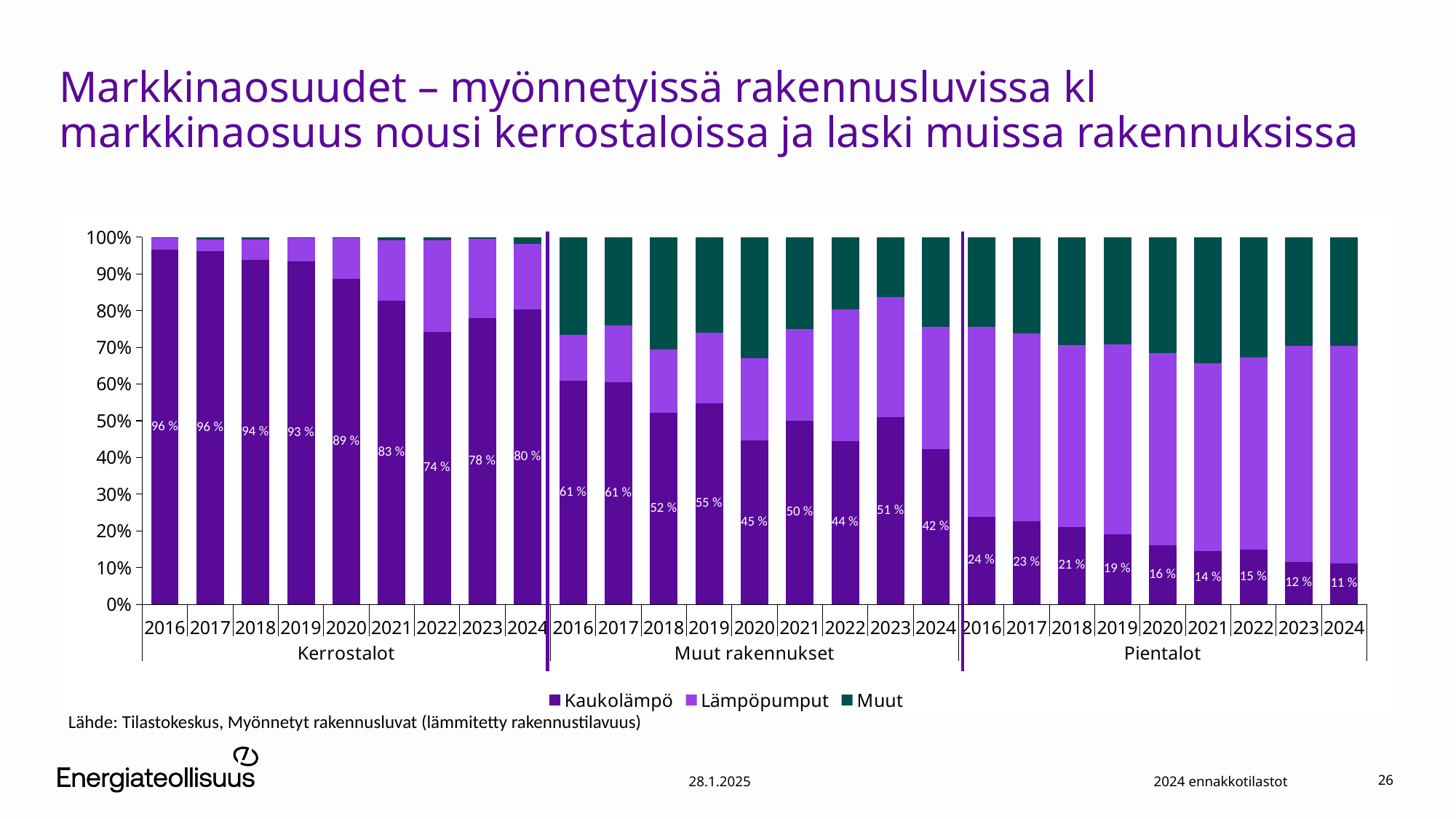
In which year is the Kaukolämpö share for Pientalot the highest? 2016 What is the Kaukolämpö share for Kerrostalot in 2024? 80 % Does the Kaukolämpö share for Pientalot rise or fall from 2016 to 2024? Fall Which year has the larger Kaukolämpö share for Muut rakennukset, 2019 or 2021? 2019 In which year is the Kaukolämpö share for Kerrostalot the lowest? 2022 What kind of chart is shown on the slide? Stacked bar chart By how many percentage points did the Kaukolämpö share for Kerrostalot fall from 2016 to 2024? 16 percentage points What is the Kaukolämpö share for Pientalot in 2016? 24 % How many series does the legend list? 3 Is the combined Kaukolämpö and Lämpöpumput share for Pientalot in 2024 greater or less than 60%? greater How many years are shown for each building group? 9 What is the Kaukolämpö share for Muut rakennukset in 2020? 45 %